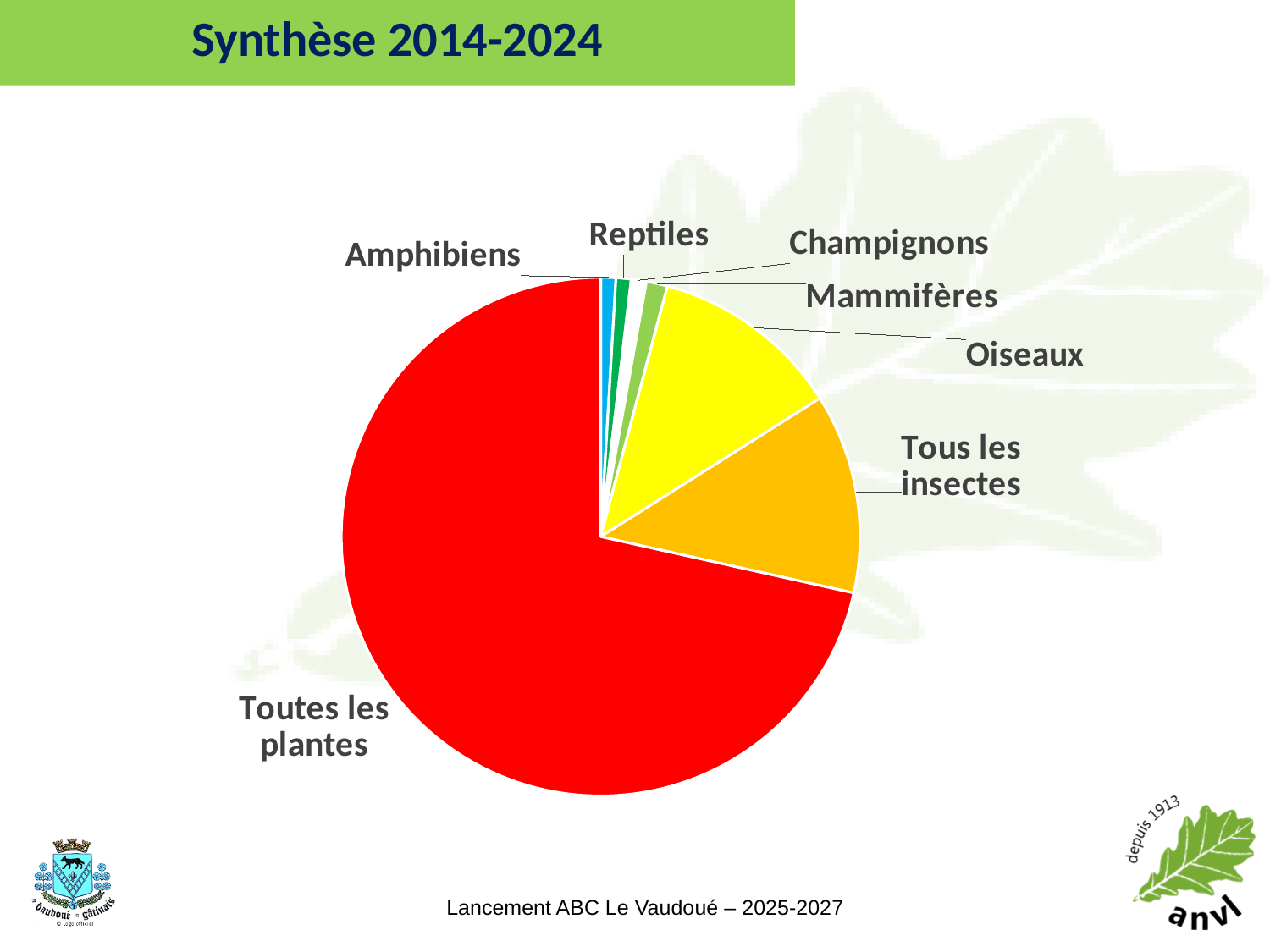
Which slice is larger, Toutes les plantes or Tous les insectes? Toutes les plantes What kind of chart is shown on the slide? pie chart Which slice is larger, Oiseaux or Mammifères? Oiseaux Which slice is larger, Toutes les plantes or Oiseaux? Toutes les plantes Which category has the largest slice of the pie chart? Toutes les plantes What colour is the Toutes les plantes slice of the pie chart? red How many slices does the pie chart have? 7 What is the title shown above the pie chart on the slide? Synthèse 2014-2024